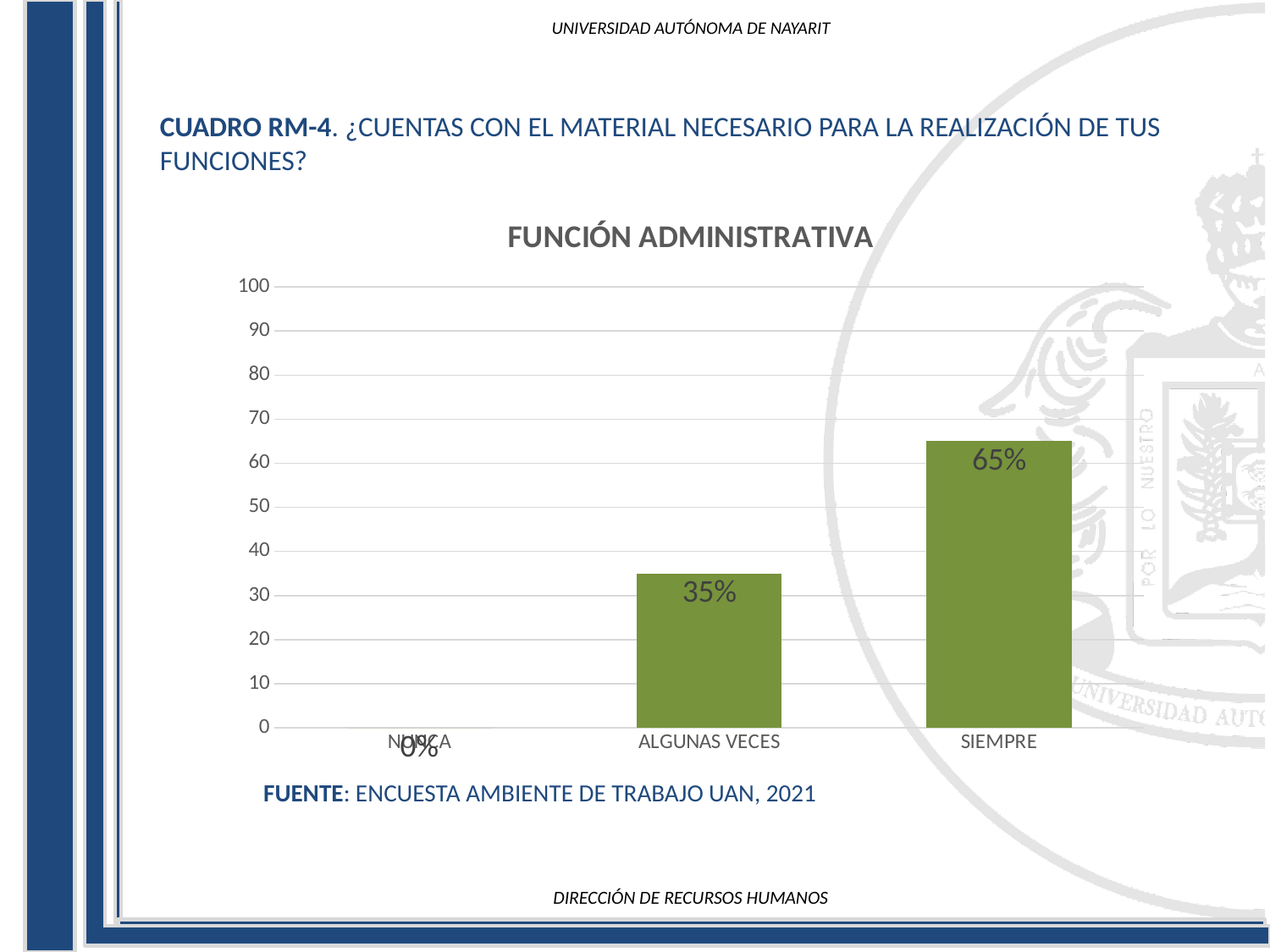
What is the title of the chart? FUNCIÓN ADMINISTRATIVA How many categories are shown on the x axis? 3 Is the value for ALGUNAS VECES greater or less than 40? less What kind of chart is shown? Bar chart Which category has the highest value? SIEMPRE Is the value for SIEMPRE greater or less than 60? greater What is the value for ALGUNAS VECES? 35% What is the difference between the values for SIEMPRE and ALGUNAS VECES? 30% Which is larger, the value for ALGUNAS VECES or the value for SIEMPRE? SIEMPRE What is the value for NUNCA? 0% What is the value for SIEMPRE? 65% Which category has the lowest value? NUNCA